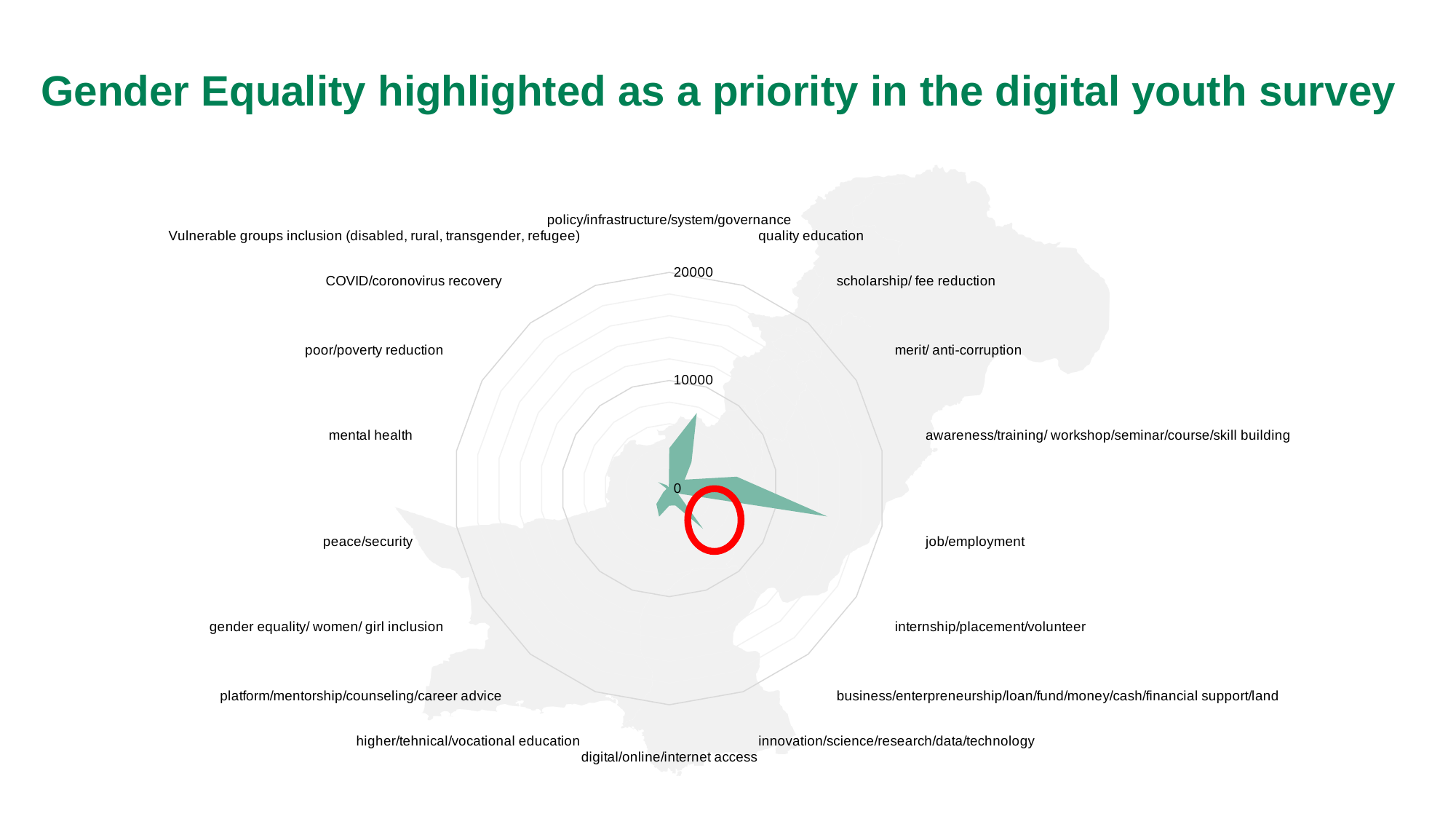
What is the title of the slide? Gender Equality highlighted as a priority in the digital youth survey Is the value for job/employment greater or less than 10000? greater Which has the larger value, job/employment or quality education? job/employment What is the highest tick value shown on the radial axis of the chart? 20000 Is the value for job/employment greater or less than 20000? less How many categories are plotted around the radar chart? 18 Which category has the highest value on the radar chart? job/employment Is the value for gender equality/ women/ girl inclusion greater or less than 10000? less Which has the larger value, job/employment or mental health? job/employment What kind of chart is shown on the slide? radar chart